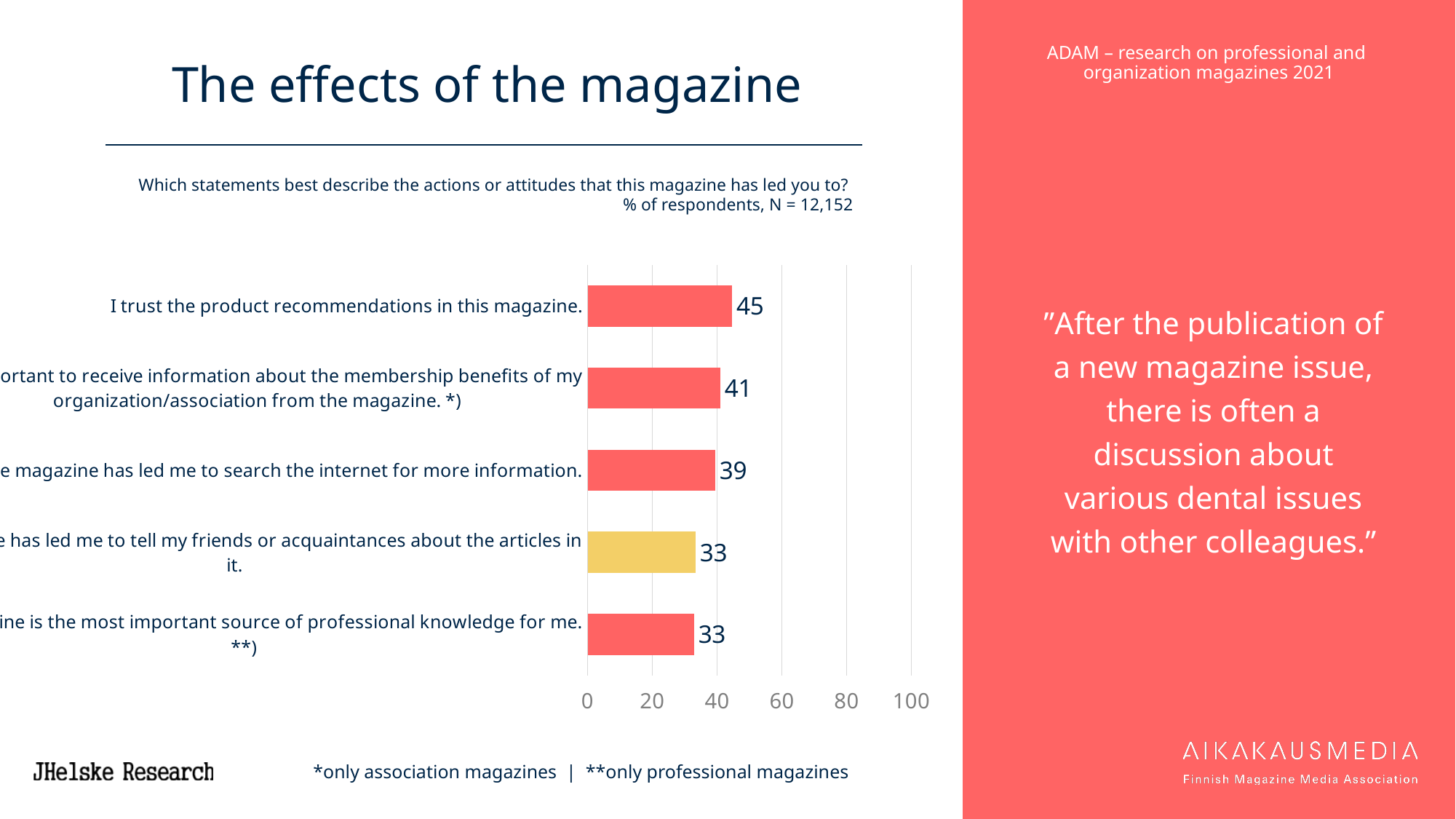
What is the lowest value shown in the chart? 33 What is the difference between the value for trusting product recommendations and the value for telling friends or acquaintances about the articles? 12 What is the value for the statement about receiving information about membership benefits of the organization/association from the magazine? 41 Which is larger: the value for searching the internet for more information or the value for receiving information about membership benefits? receiving information about membership benefits (41) Is the value for trusting product recommendations greater or less than 40? greater How many statements (bars) are shown in the chart? 5 What is the value for the statement about the magazine being the most important source of professional knowledge? 33 What is the value for the statement about the magazine leading respondents to search the internet for more information? 39 What percentage of respondents said they trust the product recommendations in this magazine? 45 What kind of chart is shown on the slide? bar chart Which bar in the chart is coloured yellow rather than red? The magazine has led me to tell my friends or acquaintances about the articles in it. Which statement has the highest value in the chart? I trust the product recommendations in this magazine.